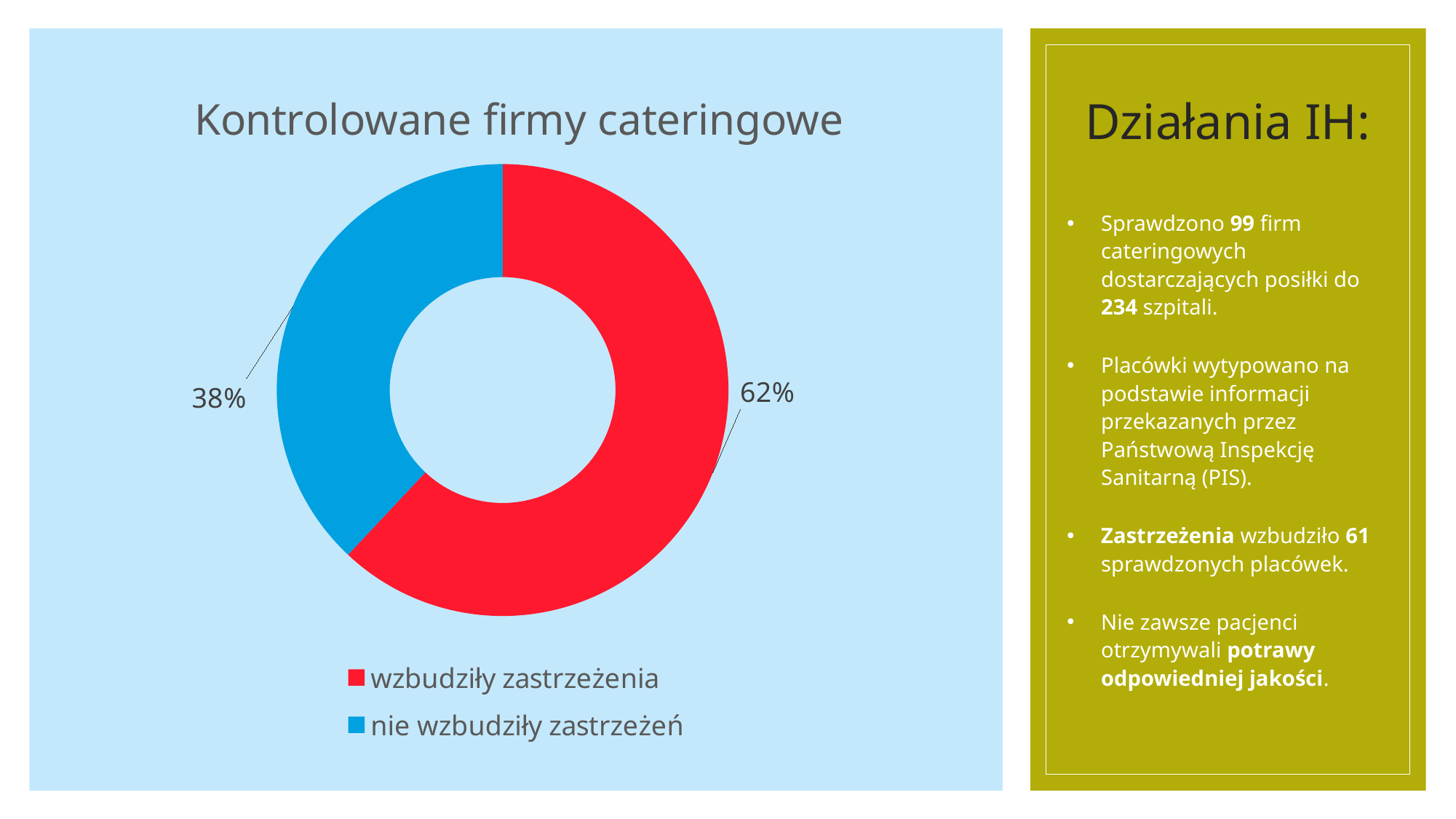
Which category has the largest share of the chart? wzbudziły zastrzeżenia What share of the chart is labelled "wzbudziły zastrzeżenia"? 62% How many categories does the chart show? 2 What is the difference in percentage points between the "wzbudziły zastrzeżenia" and "nie wzbudziły zastrzeżeń" slices? 24 percentage points What kind of chart is shown on the slide? doughnut (pie) chart What is the total of the two slices shown on the chart? 100% Which category has the smallest share of the chart? nie wzbudziły zastrzeżeń What is the title of the chart? Kontrolowane firmy cateringowe What share of the chart is labelled "nie wzbudziły zastrzeżeń"? 38% What colour is the "nie wzbudziły zastrzeżeń" slice? blue How many entries does the legend list? 2 Which slice is larger: "wzbudziły zastrzeżenia" or "nie wzbudziły zastrzeżeń"? wzbudziły zastrzeżenia